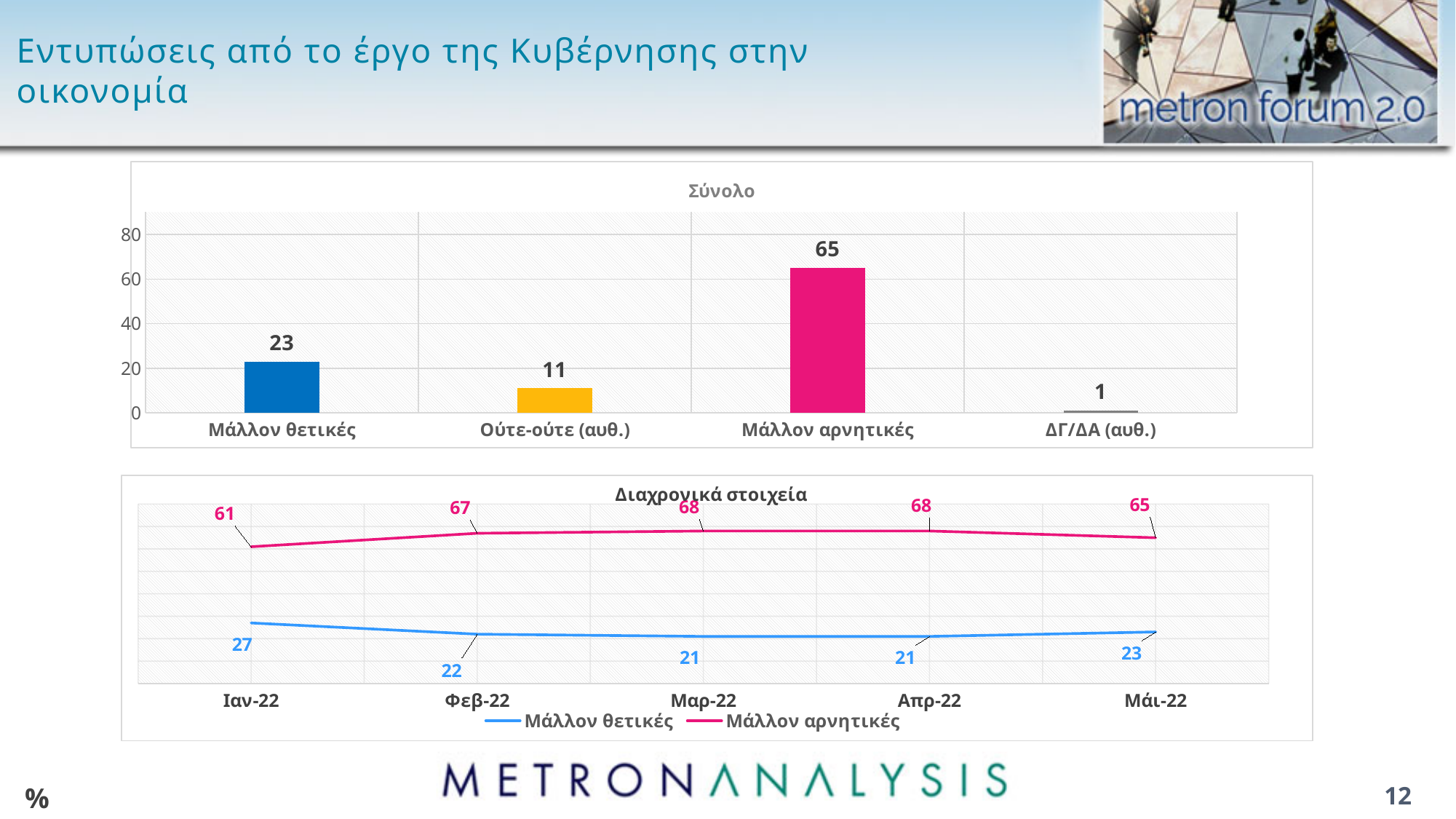
What kind of chart is the 'Σύνολο' chart? Bar chart In the 'Σύνολο' chart, which category has the highest value? Μάλλον αρνητικές In the 'Σύνολο' chart, what is the value for 'Ούτε-ούτε (αυθ.)'? 11 In the 'Σύνολο' chart, which category has the lowest value? ΔΓ/ΔΑ (αυθ.) In the 'Σύνολο' chart, what is the value for 'Μάλλον αρνητικές'? 65 In the 'Σύνολο' chart, how many categories are shown? 4 In the 'Διαχρονικά στοιχεία' chart, how many series does the legend list? 2 In the 'Διαχρονικά στοιχεία' chart, what is the value for 'Μάλλον αρνητικές' in Μαρ-22? 68 In the 'Διαχρονικά στοιχεία' chart, what is the difference between 'Μάλλον αρνητικές' and 'Μάλλον θετικές' in Μάι-22? 42 In the 'Διαχρονικά στοιχεία' chart, what is the value for 'Μάλλον θετικές' in Ιαν-22? 27 In the 'Σύνολο' chart, what is the difference between 'Μάλλον αρνητικές' and 'Μάλλον θετικές'? 42 In the 'Διαχρονικά στοιχεία' chart, which is larger in Φεβ-22: 'Μάλλον θετικές' or 'Μάλλον αρνητικές'? Μάλλον αρνητικές